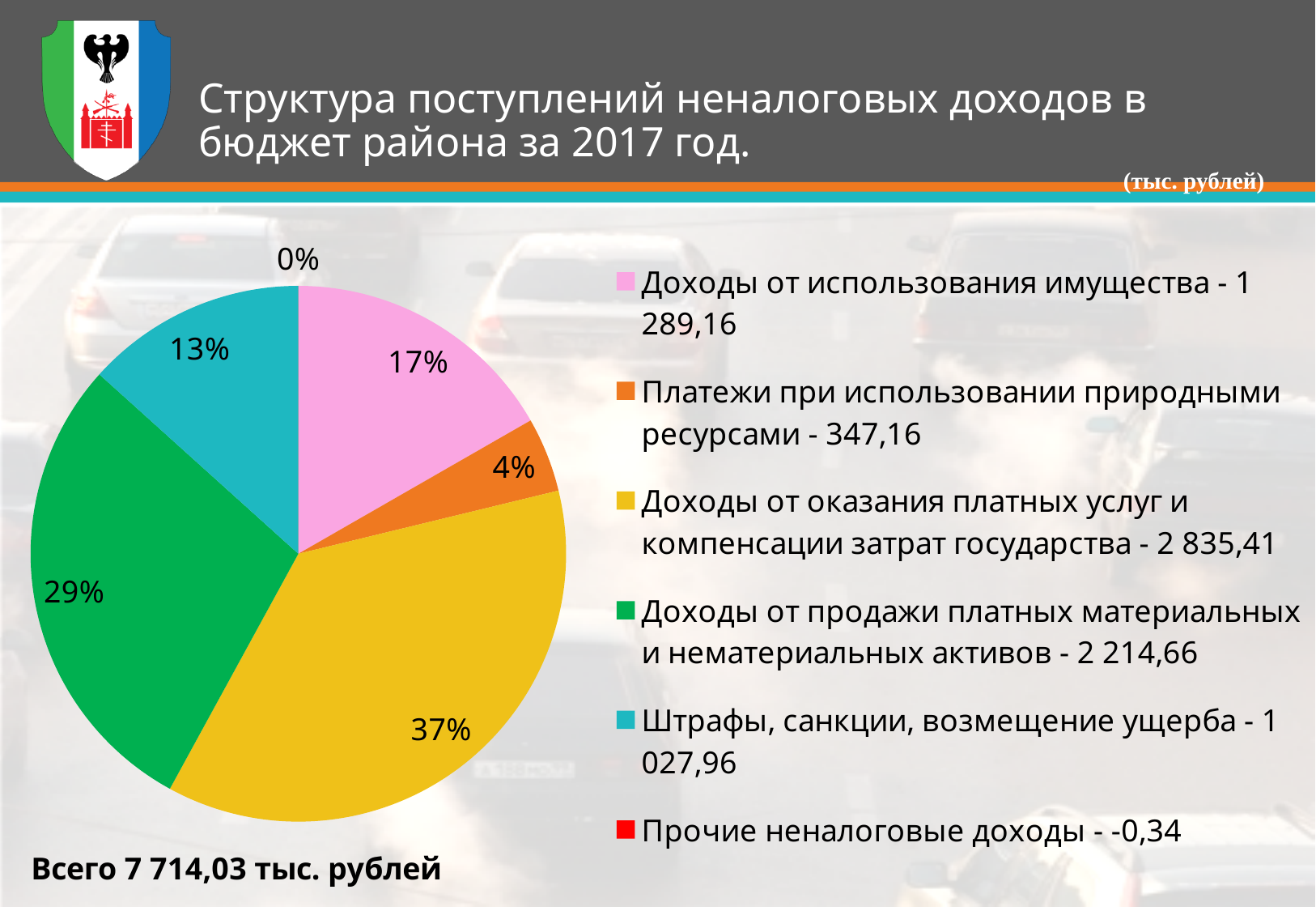
What share of the pie does "Доходы от использования имущества" represent? 17% What share of the pie does "Штрафы, санкции, возмещение ущерба" represent? 13% What kind of chart is shown on the slide? pie chart Which is larger: the slice for "Доходы от продажи платных материальных и нематериальных активов" or the slice for "Штрафы, санкции, возмещение ущерба"? Доходы от продажи платных материальных и нематериальных активов Which category has the smallest slice of the pie? Прочие неналоговые доходы What share of the pie does "Доходы от оказания платных услуг и компенсации затрат государства" represent? 37% What total amount is stated at the bottom of the slide? 7 714,03 тыс. рублей Which category has the largest slice of the pie? Доходы от оказания платных услуг и компенсации затрат государства What value is given in the legend for "Платежи при использовании природными ресурсами"? 347,16 How many categories does the legend list? 6 What is the difference in percentage points between the 37% slice and the 29% slice? 8%